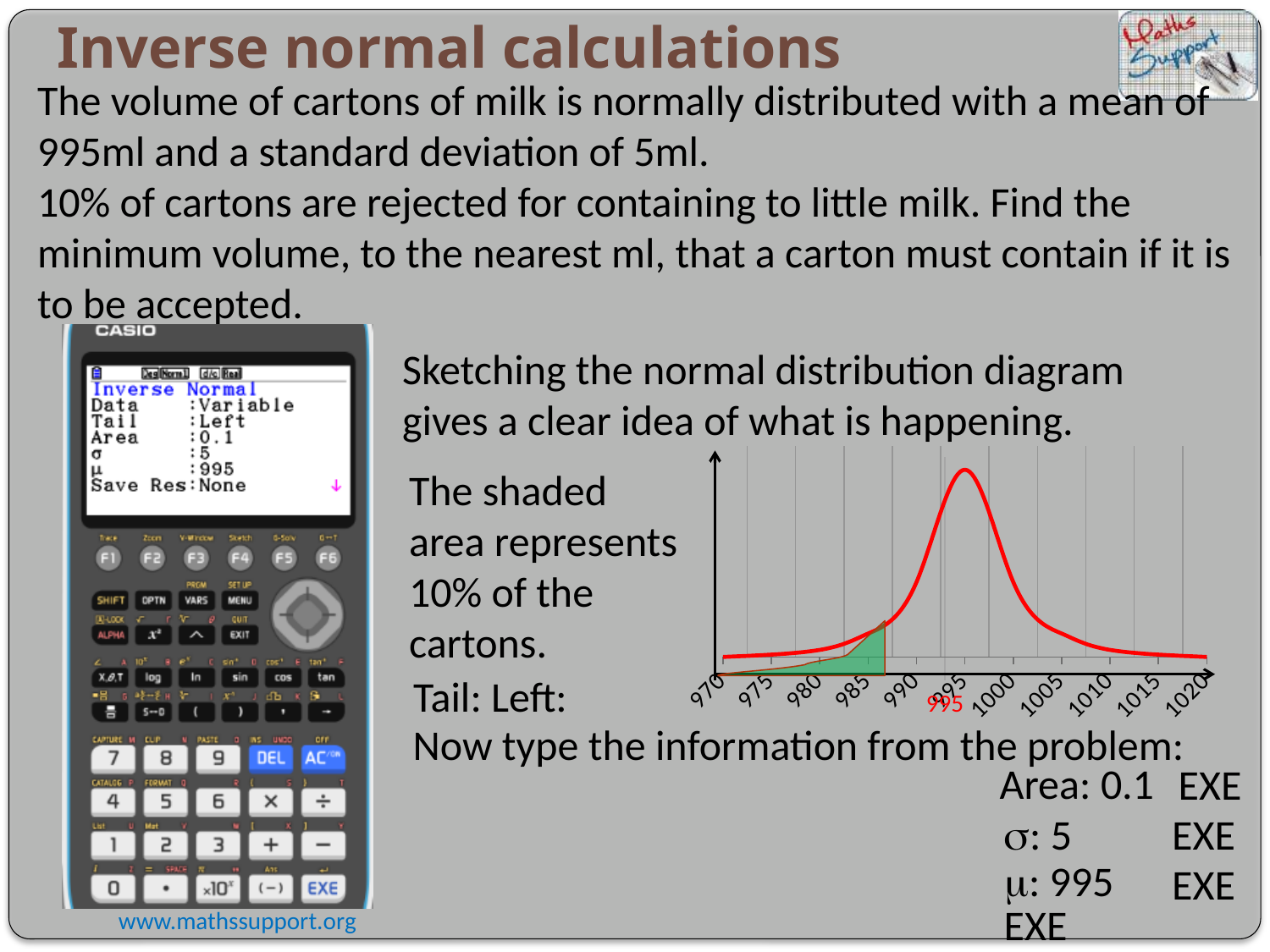
How many labelled tick marks are on the x axis of the normal distribution chart? 11 What colour is the shaded area under the left tail of the curve? green Is the curve higher at x = 980 or at x = 1000? 1000 What is the largest value labelled on the x axis of the chart? 1020 Which x-axis label is written in red beneath the chart? 995 What kind of chart is shown on the right of the slide? line chart At which x-axis value does the red curve reach its peak? 995 What is the spacing between consecutive labels on the x axis? 5 Does the red curve rise or fall as x increases from 970 to 995? rise Does the red curve rise or fall as x increases from 995 to 1020? fall What is the smallest value labelled on the x axis of the chart? 970 Is the curve higher at x = 995 or at x = 1010? 995